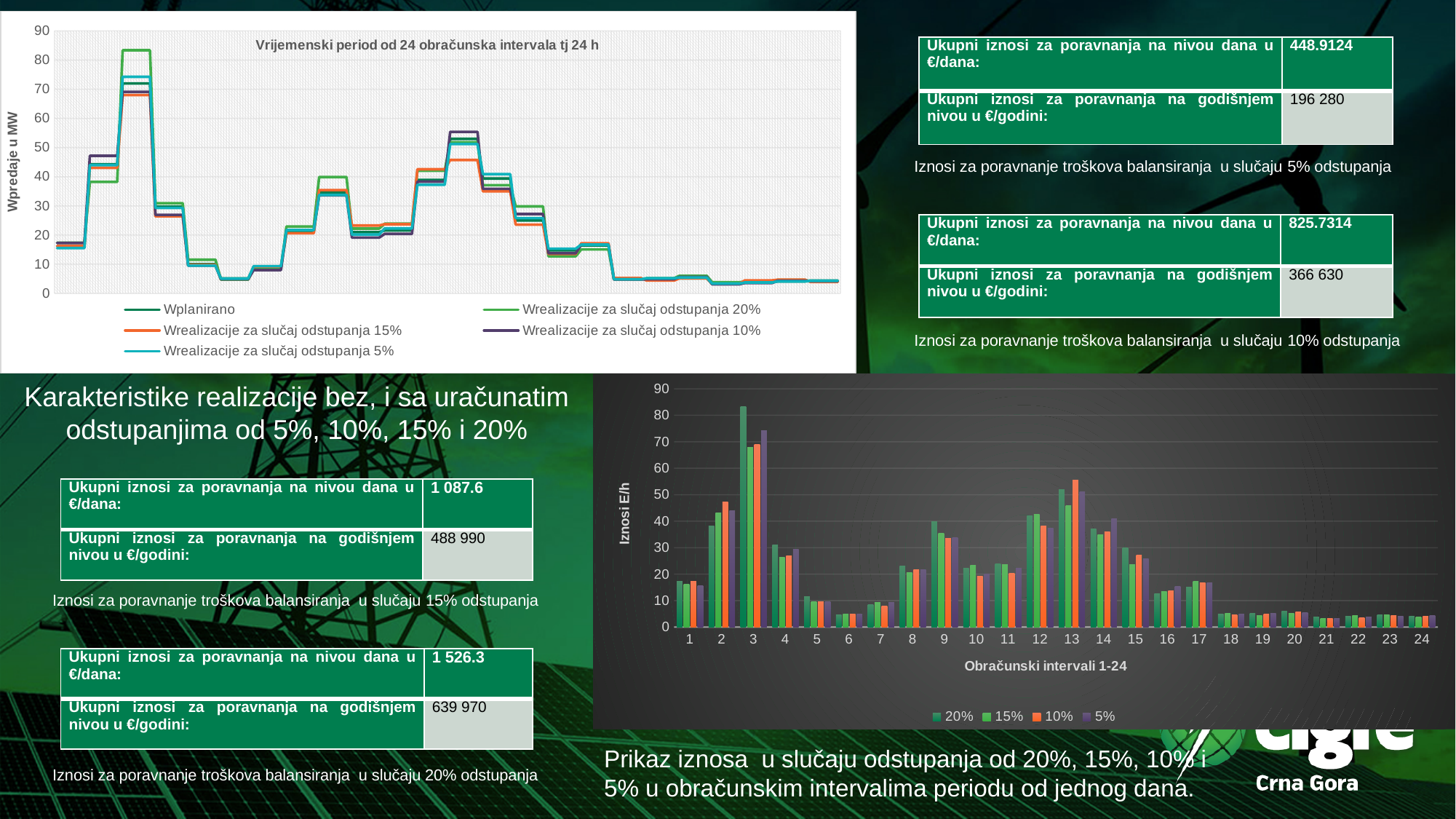
In the bottom-right bar chart, do the values for 20% rise or fall from interval 13 to interval 16? fall What kind of chart is the chart in the top-left of the slide? line chart What is the x-axis title of the bottom-right bar chart? Obračunski intervali 1-24 In the bottom-right bar chart, which interval has the tallest bar? 3 What kind of chart is the chart in the bottom-right of the slide? bar chart In the bottom-right bar chart, how many series does the legend list? 4 In the bottom-right bar chart, how many intervals (categories) are shown on the x axis? 24 In the bottom-right bar chart, is the value for 20% at interval 6 greater or less than 10? less What is the title of the top-left line chart? Vrijemenski period od 24 obračunska intervala tj 24 h In the top-left line chart, how many series does the legend list? 5